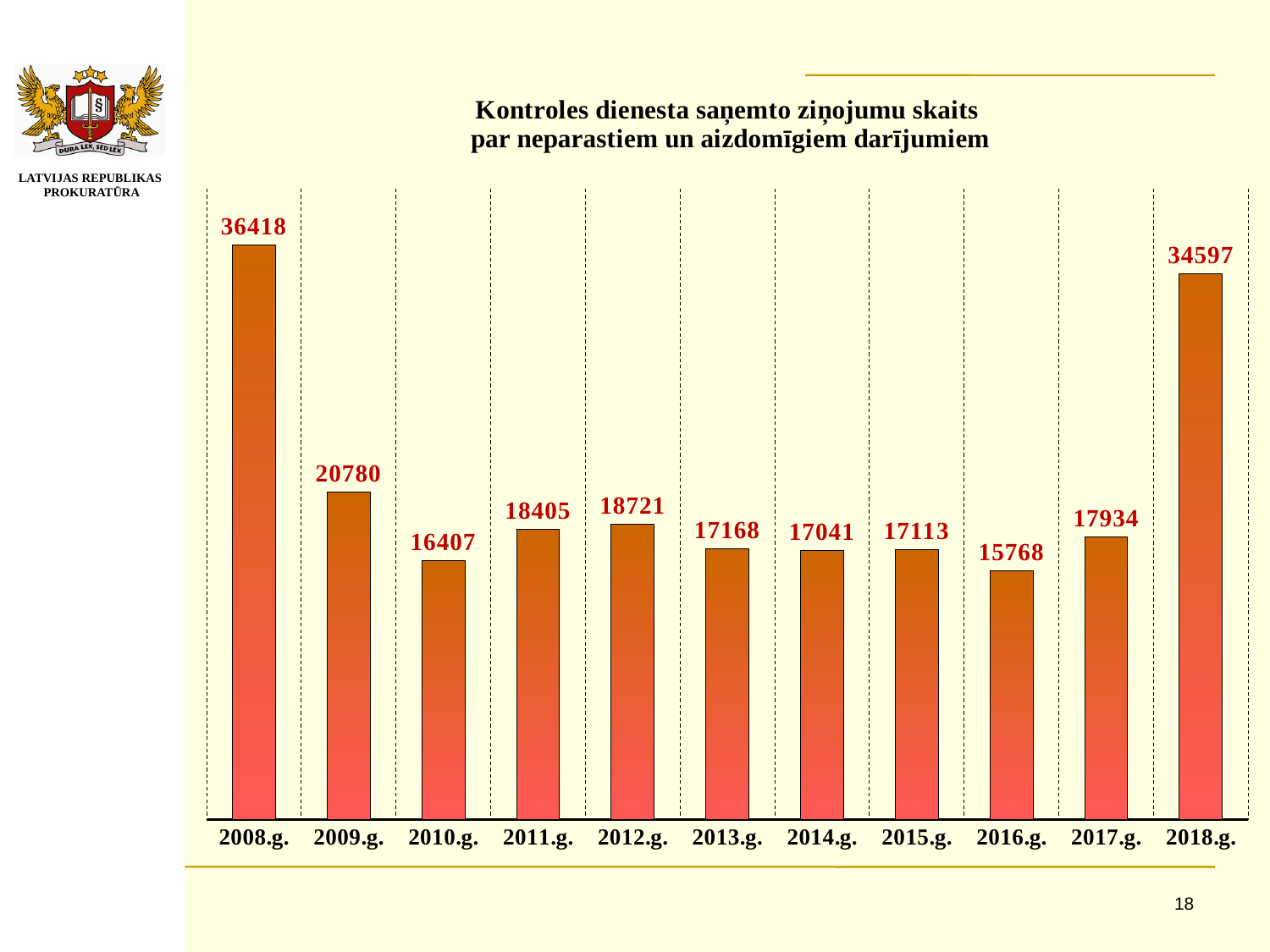
How many years are shown on the x axis? 11 What is the title of the chart? Kontroles dienesta saņemto ziņojumu skaits par neparastiem un aizdomīgiem darījumiem What is the value for 2018.g.? 34597 What is the difference between the values for 2008.g. and 2018.g.? 1821 What is the value for 2008.g.? 36418 Which year has the highest value? 2008.g. What kind of chart is this? bar chart Do the values rise or fall from 2008.g. to 2010.g.? fall Which year has the lowest value? 2016.g. Which is larger, the value for 2011.g. or the value for 2012.g.? 2012.g. What is the value for 2016.g.? 15768 What is the difference between the values for 2009.g. and 2010.g.? 4373